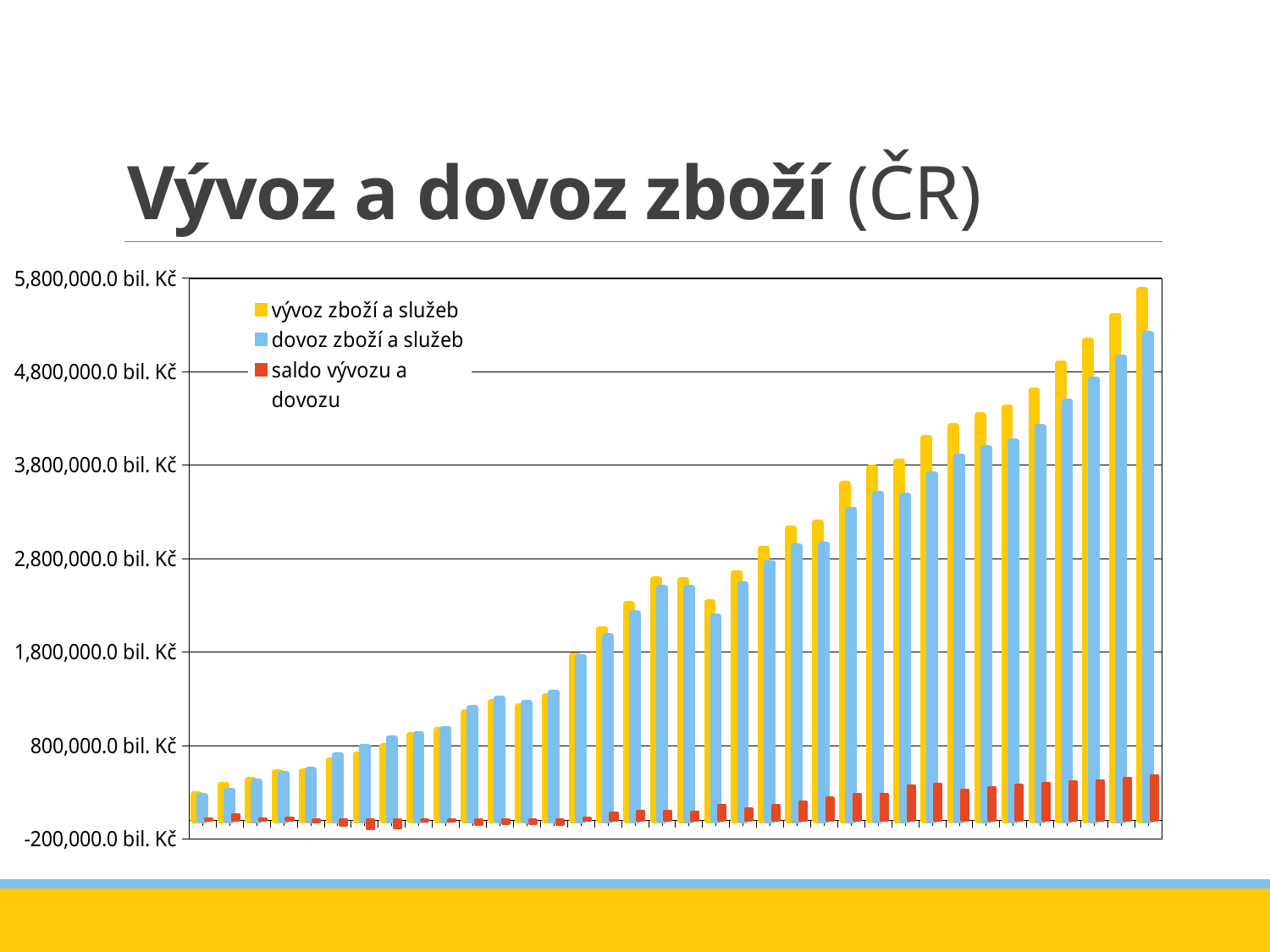
How many series does the chart legend list? 3 Do the values for vývoz zboží a služeb rise or fall along the x axis? rise Which series reaches the highest value in the chart? vývoz zboží a služeb Is the highest value of saldo vývozu a dovozu greater or less than 800,000.0 bil. Kč? less Do the values for dovoz zboží a služeb rise or fall along the x axis? rise Which series has the lowest values in the chart? saldo vývozu a dovozu What is the highest value shown on the y axis? 5,800,000.0 bil. Kč What kind of chart is shown on the slide? bar chart Which series is shown in yellow in the chart? vývoz zboží a služeb What is the title of the slide containing the chart? Vývoz a dovoz zboží (ČR) Is the highest value of vývoz zboží a služeb greater or less than 4,800,000.0 bil. Kč? greater